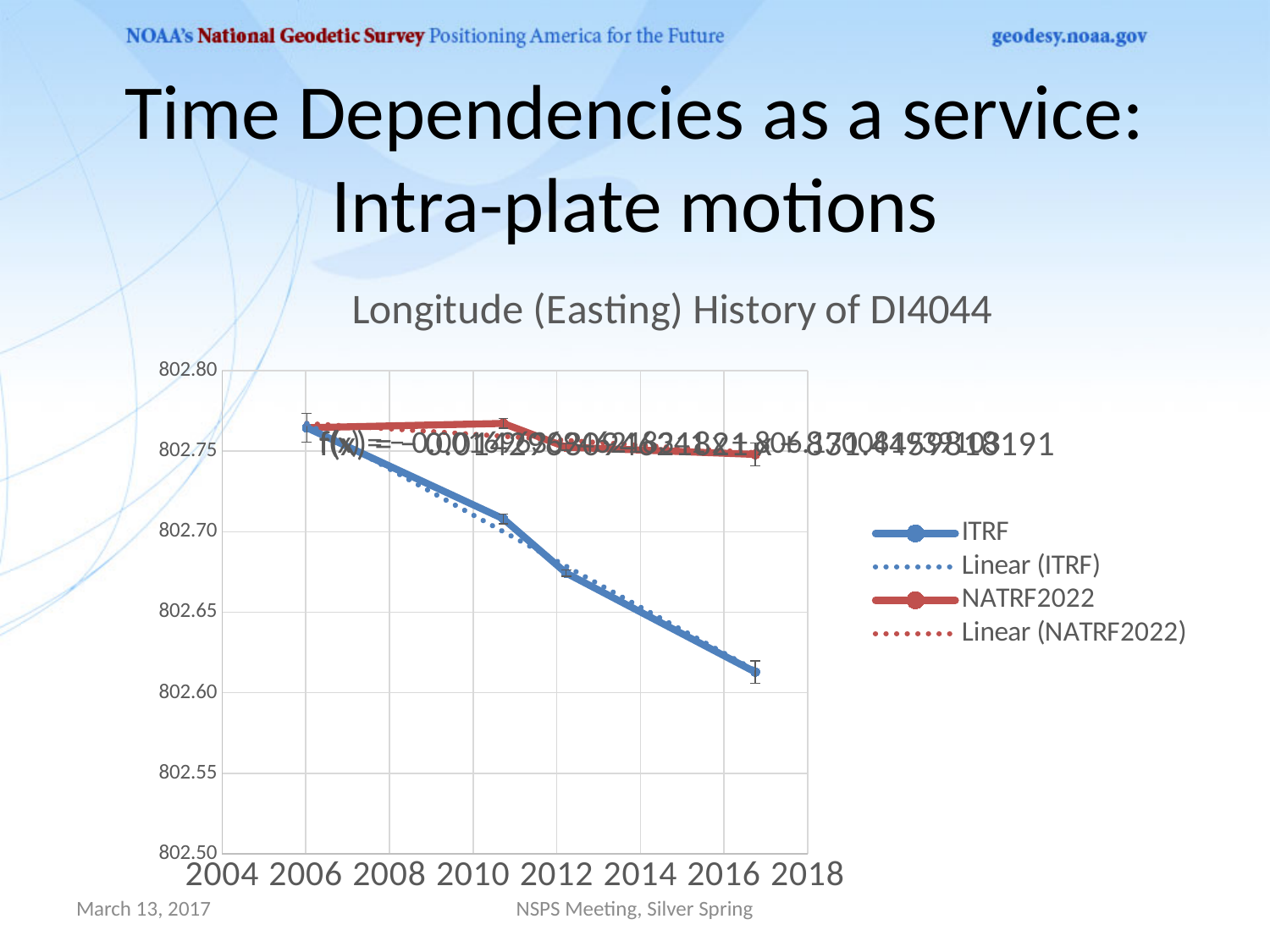
Is the NATRF2022 value at the last point (around 2017) greater or less than 802.70? greater What kind of chart is shown on the slide? line chart How many data points are plotted on the ITRF line? 4 What is the title of the chart? Longitude (Easting) History of DI4044 Is the ITRF value at the last point (around 2017) greater or less than 802.65? less Is the ITRF value at the first point (around 2006) greater or less than 802.75? greater What colour is used for the NATRF2022 series? red At the last plotted point (around 2017), which series has the higher value, ITRF or NATRF2022? NATRF2022 How many entries does the chart's legend list? 4 Do the ITRF values rise or fall as the years increase along the x axis? fall At which year does the ITRF series have its highest value? 2006